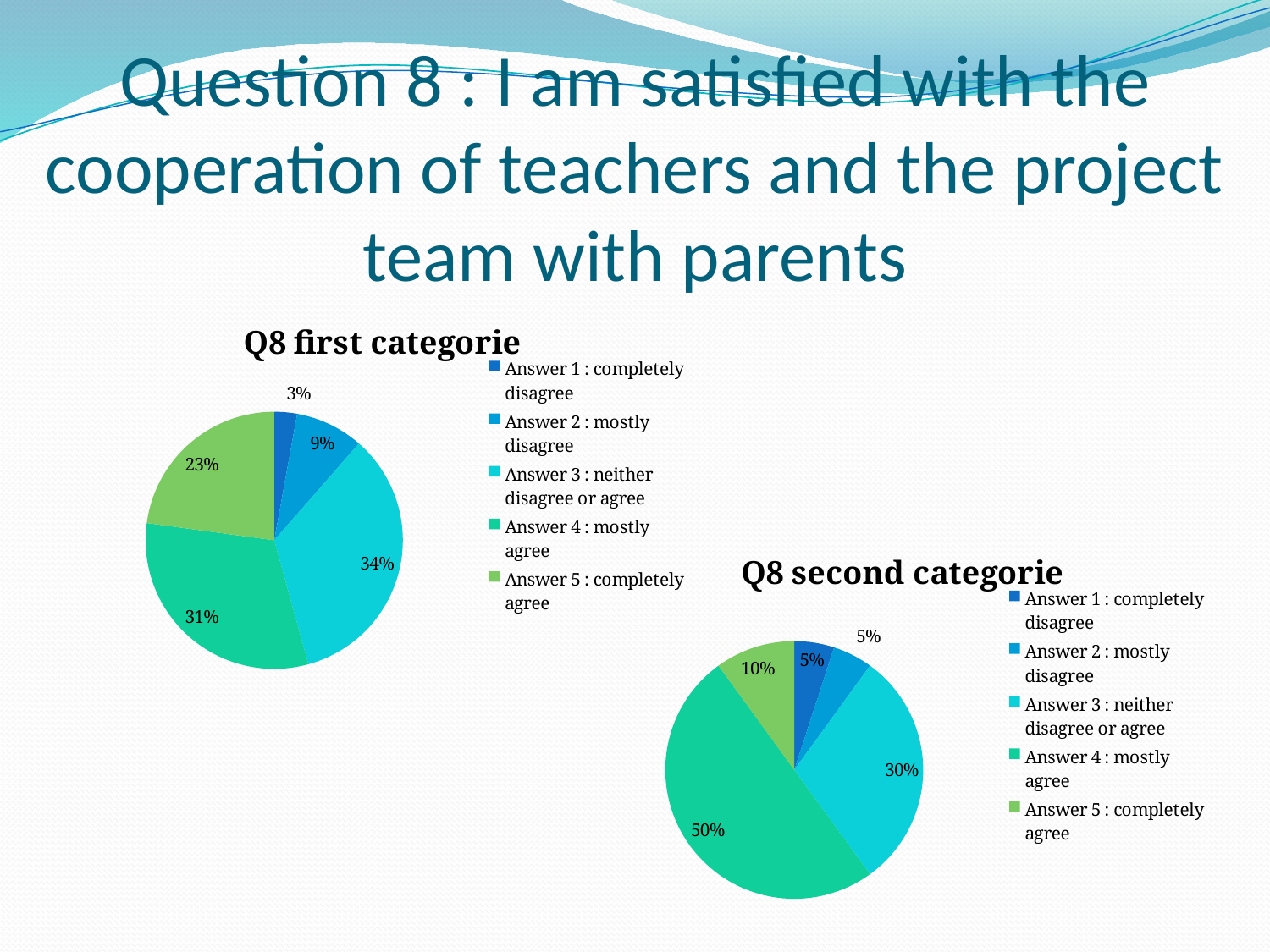
In the 'Q8 first categorie' chart, what percentage is shown for Answer 3 : neither disagree or agree? 34% In the 'Q8 first categorie' chart, what percentage is shown for Answer 5 : completely agree? 23% In the 'Q8 first categorie' chart, what is the difference between the shares for Answer 3 and Answer 4? 3% In the 'Q8 second categorie' chart, what is the difference between the shares for Answer 4 and Answer 3? 20% In the 'Q8 second categorie' chart, what percentage is shown for Answer 3 : neither disagree or agree? 30% In the 'Q8 first categorie' chart, which answer has the smallest share? Answer 1 : completely disagree What type of chart is 'Q8 first categorie'? Pie chart In the 'Q8 second categorie' chart, which answer has the largest share? Answer 4 : mostly agree In the 'Q8 second categorie' chart, which is larger: the share for Answer 5 : completely agree or Answer 1 : completely disagree? Answer 5 : completely agree In the 'Q8 first categorie' chart, which answer has the largest share? Answer 3 : neither disagree or agree In the 'Q8 second categorie' chart, what percentage is shown for Answer 4 : mostly agree? 50% How many entries does the legend of the 'Q8 second categorie' chart list? 5